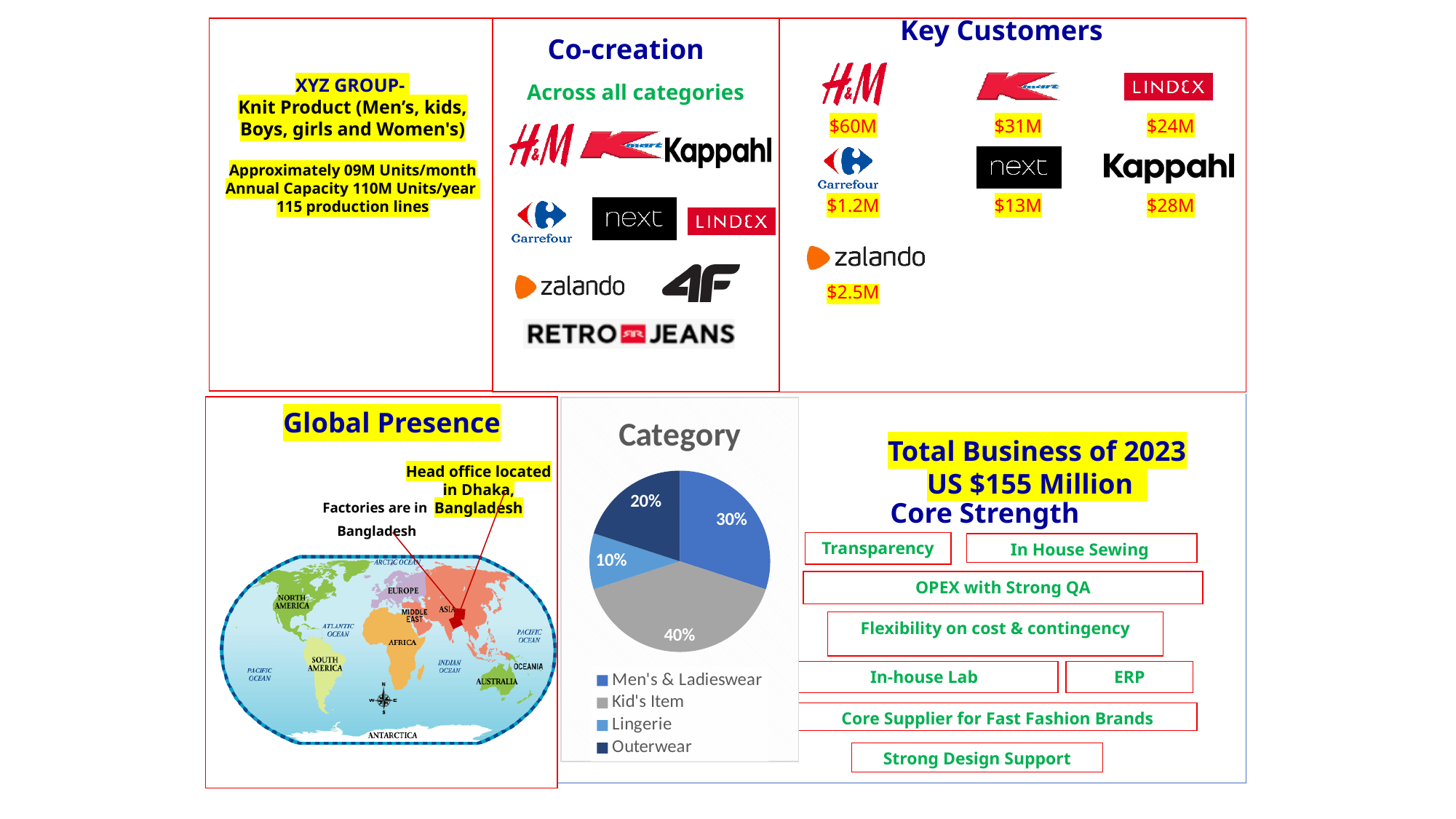
What is the title of the pie chart on the slide? Category In the "Category" pie chart, what share does Lingerie have? 10% In the "Category" pie chart, which category is shown in grey? Kid's Item What kind of chart is the "Category" chart on the slide? pie chart In the "Category" pie chart, what share does Men's & Ladieswear have? 30% In the "Category" pie chart, what share does Kid's Item have? 40% Which category has the smallest slice in the "Category" pie chart? Lingerie How many categories are shown in the "Category" pie chart? 4 In the "Category" pie chart, what share does Outerwear have? 20% In the "Category" pie chart, what is the difference between the Kid's Item share and the Outerwear share? 20% In the "Category" pie chart, which is larger: Men's & Ladieswear or Outerwear? Men's & Ladieswear Which category has the largest slice in the "Category" pie chart? Kid's Item